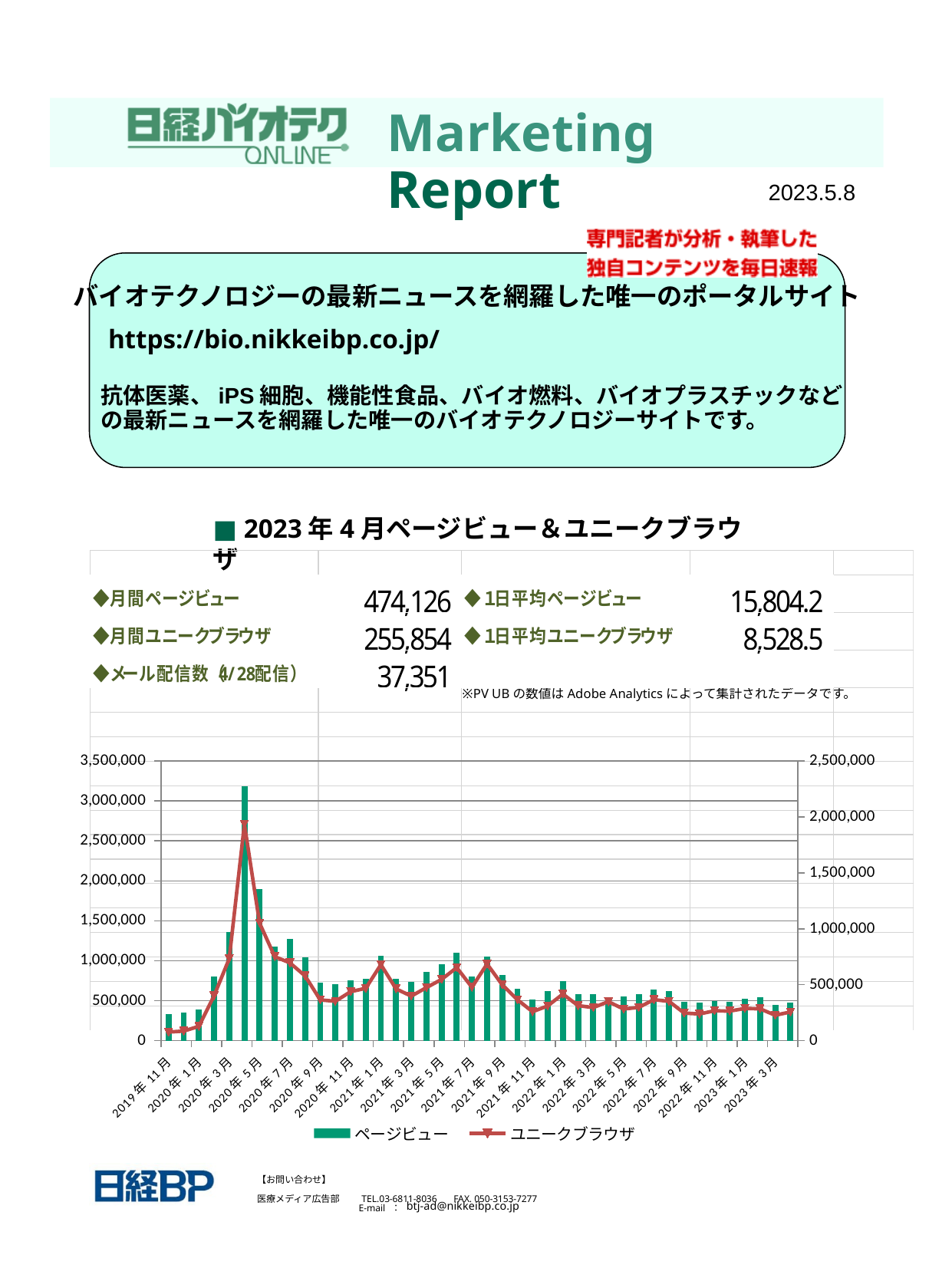
What is the 1日平均ページビュー value shown on the slide? 15,804.2 Is the page view (ページビュー) bar for 2023年3月 greater or less than 1,000,000? less Which has the larger page view (ページビュー) bar, 2020年1月 or 2021年1月? 2021年1月 What is the maximum value shown on the left vertical axis of the chart? 3,500,000 How many series does the chart legend list? 2 After the peak in 2020, do the page view bars generally rise or fall toward 2023年3月? fall Is the page view (ページビュー) bar for 2019年11月 greater or less than 500,000? less Is the tallest page view (ページビュー) bar greater or less than 3,000,000? greater What kind of chart is shown at the bottom of the slide? A bar chart combined with a line chart What is the 月間ユニークブラウザ value shown for April 2023? 255,854 What is the 月間ページビュー value shown for April 2023? 474,126 What are the two series named in the chart legend? ページビュー and ユニークブラウザ